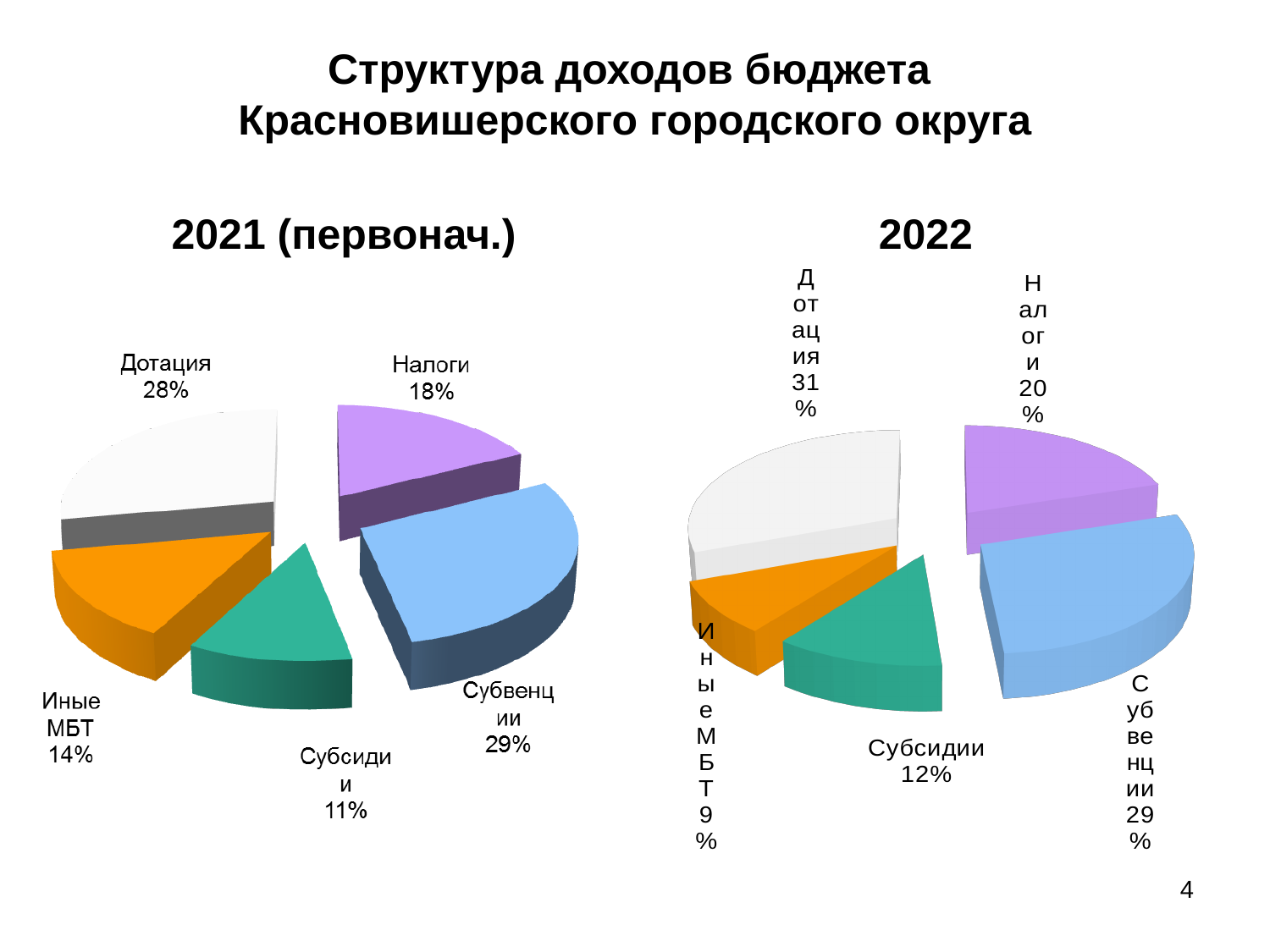
On the 2021 (первонач.) chart, which category has the largest share? Субвенции What kind of chart is the 2021 (первонач.) chart? Pie chart On the 2021 (первонач.) chart, what share does Дотация have? 28% On the 2021 (первонач.) chart, which category has the smallest share? Субсидии How many categories does the 2022 chart show? 5 On the 2022 chart, which category has the smallest share? Иные МБТ On the 2021 (первонач.) chart, what is the value for Субсидии? 11% On the 2022 chart, which category has the largest share? Дотация On the 2022 chart, what share does Налоги have? 20% On the 2022 chart, what is the difference between the shares of Субвенции and Субсидии? 17% On the 2021 (первонач.) chart, which is larger: Дотация or Налоги? Дотация On the 2022 chart, what is the value for Иные МБТ? 9%